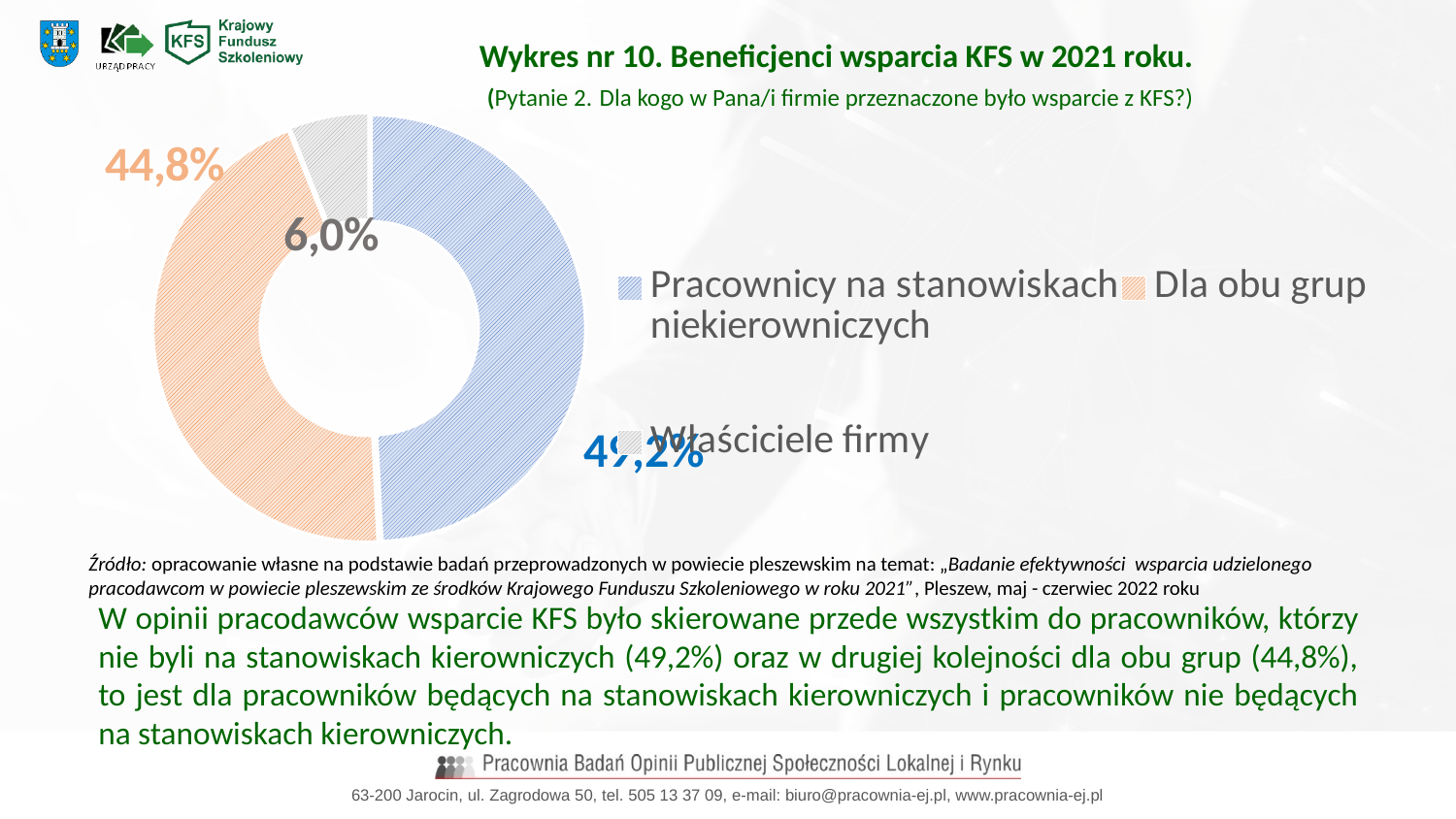
What kind of chart is shown on the slide? Pie chart (doughnut) Which category has the smallest share of the chart? Właściciele firmy What is the title of the chart? Wykres nr 10. Beneficjenci wsparcia KFS w 2021 roku. What is the difference in percentage points between "Pracownicy na stanowiskach niekierowniczych" and "Dla obu grup"? 4,4 Which is larger: the share for "Dla obu grup" or the share for "Właściciele firmy"? Dla obu grup What percentage of the chart is for "Dla obu grup"? 44,8% How many categories does the chart show? 3 What is the difference in percentage points between "Dla obu grup" and "Właściciele firmy"? 38,8 Which colour represents "Dla obu grup" in the chart? Orange What percentage of the chart is for "Właściciele firmy"? 6,0% What percentage of the chart is for "Pracownicy na stanowiskach niekierowniczych"? 49,2% Which category has the largest share of the chart? Pracownicy na stanowiskach niekierowniczych